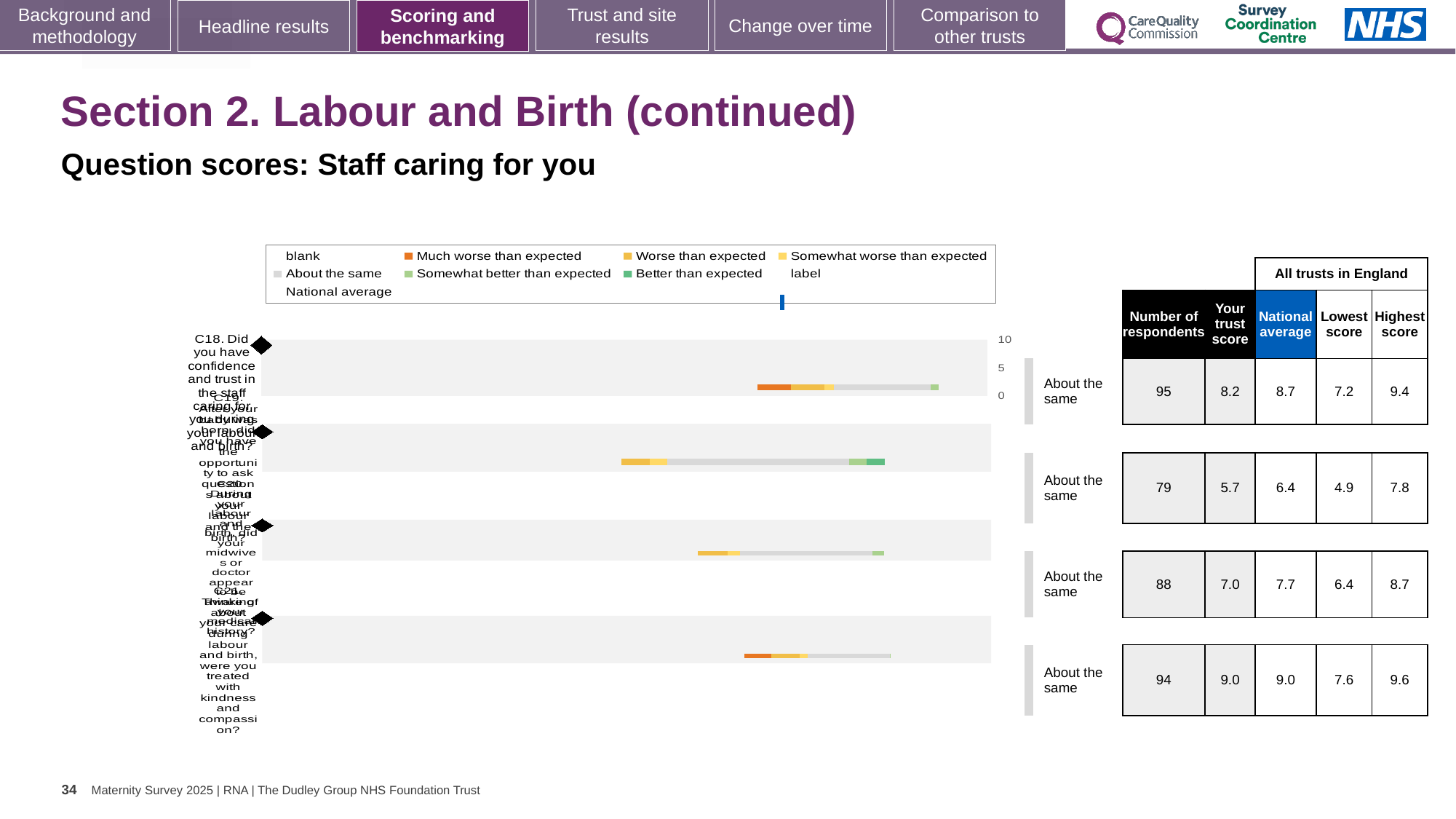
What is the 'Your trust score' for question C18 (the first row)? 8.2 For question C18, which is larger: the trust score or the national average? the national average What is the national average for question C18 (the first row)? 8.7 What is the lowest score across all trusts in England for the third row? 6.4 Which row has the lowest 'Your trust score'? the second row, 5.7 For the second row, what is the difference between the national average and the trust score? 0.7 What kind of chart is shown on the slide? bar chart What is the highest score across all trusts in England for question C21 (the fourth row)? 9.6 Which row has the highest 'Your trust score'? C21 (the fourth row), 9.0 How many question rows (bars) are plotted in the chart? 4 How many respondents are listed for the second row of the table? 79 What benchmark category is shown next to every row of the chart? About the same